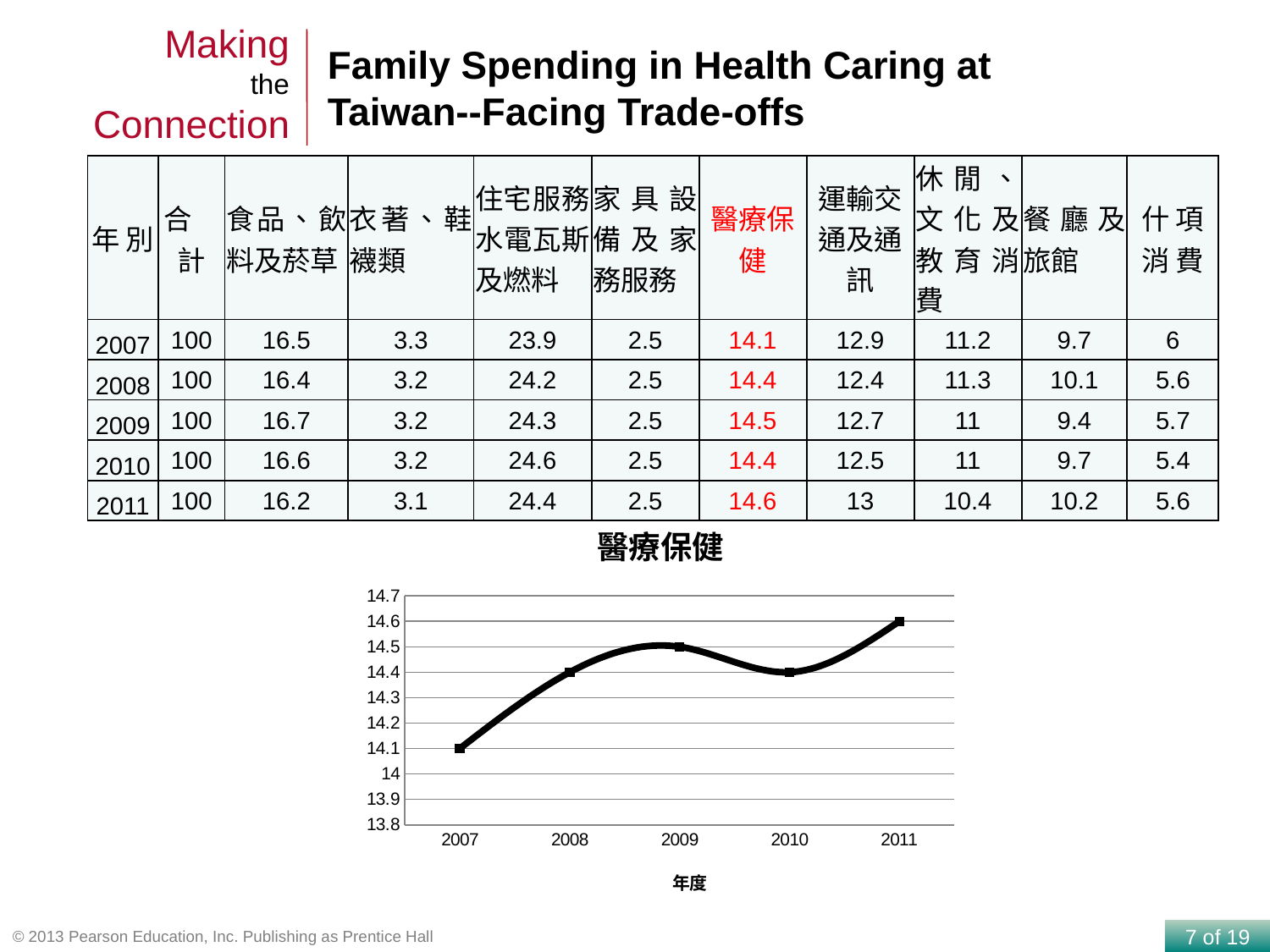
How many years are plotted in the 醫療保健 line chart? 5 What kind of chart is shown under the table on the slide? Line chart What is the x-axis title of the 醫療保健 line chart? 年度 What is the value for 2009 in the 醫療保健 line chart? 14.5 In the 醫療保健 line chart, what is the difference between the values for 2011 and 2007? 0.5 What is the value for 2011 in the 醫療保健 line chart? 14.6 Which year has the lowest value in the 醫療保健 line chart? 2007 Which year has the highest value in the 醫療保健 line chart? 2011 What is the value for 2007 in the 醫療保健 line chart? 14.1 In the 醫療保健 line chart, is the value for 2008 greater or less than 14.2? greater In the 醫療保健 line chart, which is larger, the value for 2009 or the value for 2010? 2009 In the 醫療保健 line chart, does the value rise or fall from 2009 to 2010? Fall